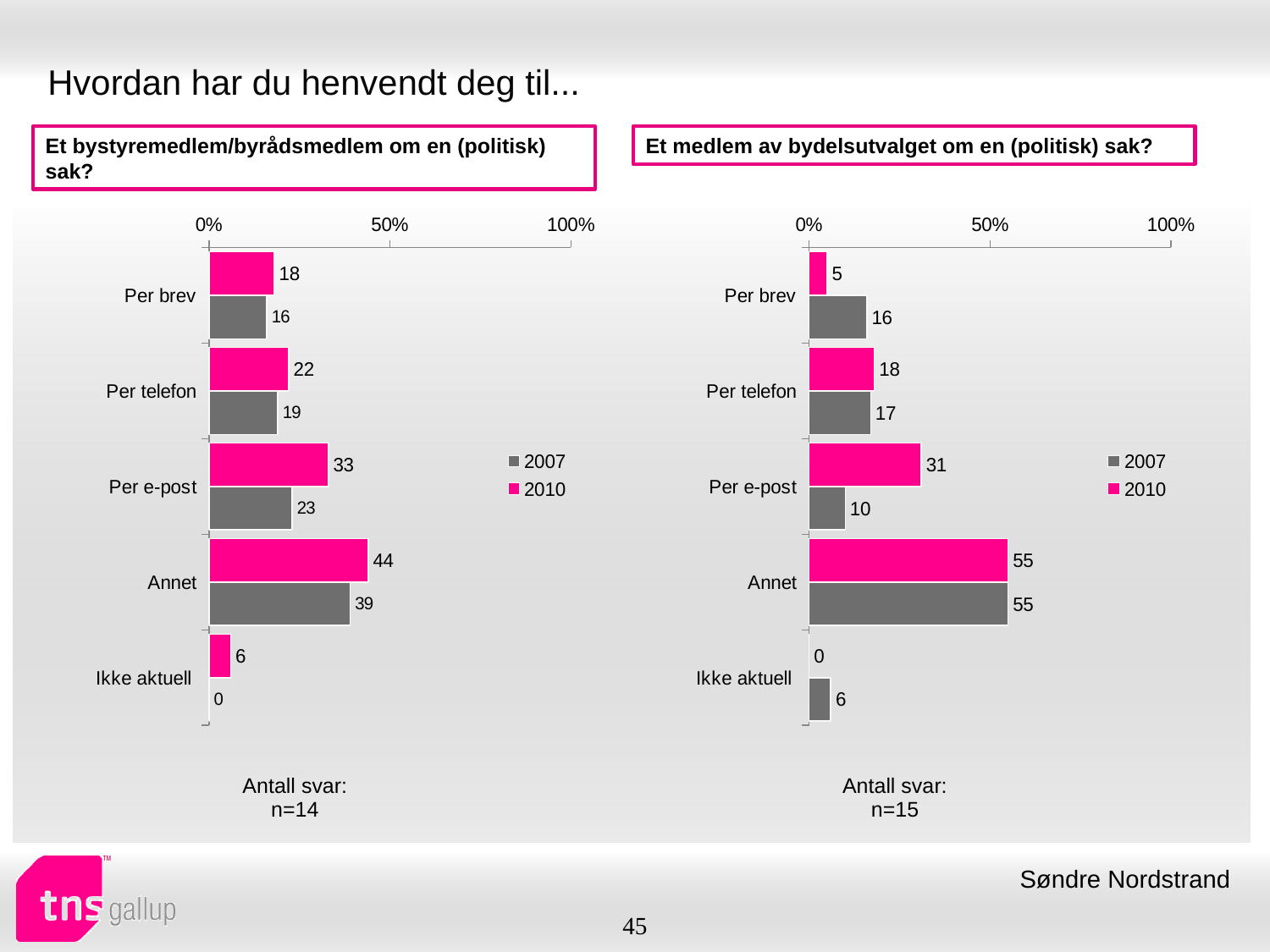
In the left chart, which category has the highest 2010 value? Annet What type of chart is the left chart? Bar chart How many categories are shown in the left chart? 5 In the left chart (Et bystyremedlem/byrådsmedlem om en (politisk) sak?), what is the 2010 value for Per e-post? 33 In the right chart, which category has the lowest 2010 value? Ikke aktuell In the right chart, which is larger for Per e-post: the 2007 value or the 2010 value? 2010 In the right chart (Et medlem av bydelsutvalget om en (politisk) sak?), what is the 2007 value for Per e-post? 10 In the right chart, is the 2010 value for Annet greater or less than 50%? greater How many series does the legend of the right chart list? 2 In the left chart, what is the number of responses (Antall svar) shown below the chart? n=14 In the right chart, what is the difference between the 2007 and 2010 values for Per brev? 11 In the left chart, what is the difference between the 2010 and 2007 values for Annet? 5